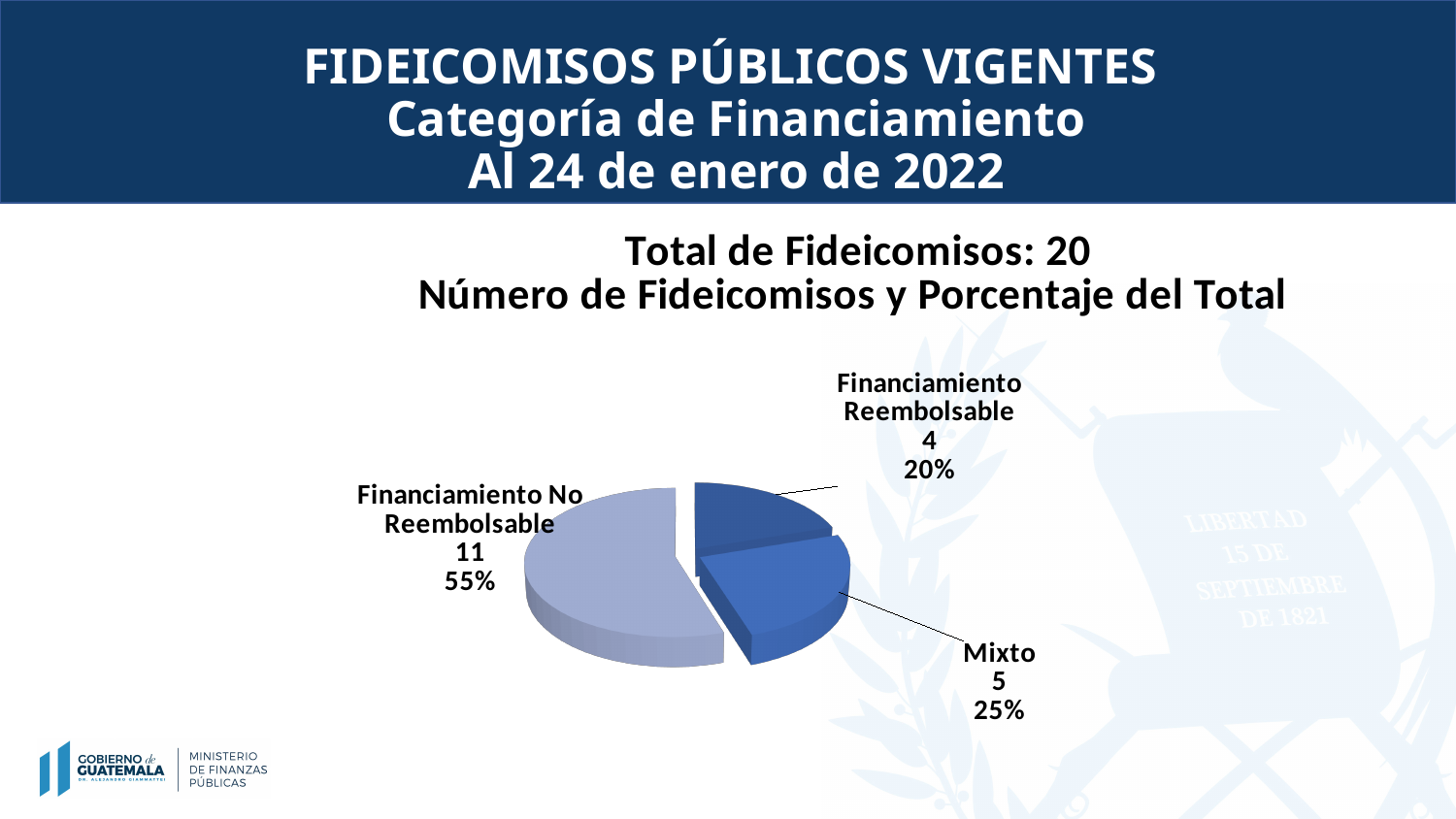
What date is given in the chart title? 24 de enero de 2022 How many fideicomisos are in the Financiamiento No Reembolsable category? 11 Which category has the smallest number of fideicomisos? Financiamiento Reembolsable Which category has the largest number of fideicomisos? Financiamiento No Reembolsable How many slices does the pie chart have? 3 Which has more fideicomisos, Mixto or Financiamiento Reembolsable? Mixto How many fideicomisos are in the Mixto category? 5 What is the total number of fideicomisos shown on the slide? 20 What is the difference in the number of fideicomisos between Financiamiento No Reembolsable and Mixto? 6 What share of the pie does Mixto represent? 25% What percentage of the total does Financiamiento Reembolsable represent? 20% What kind of chart is shown on the slide? Pie chart